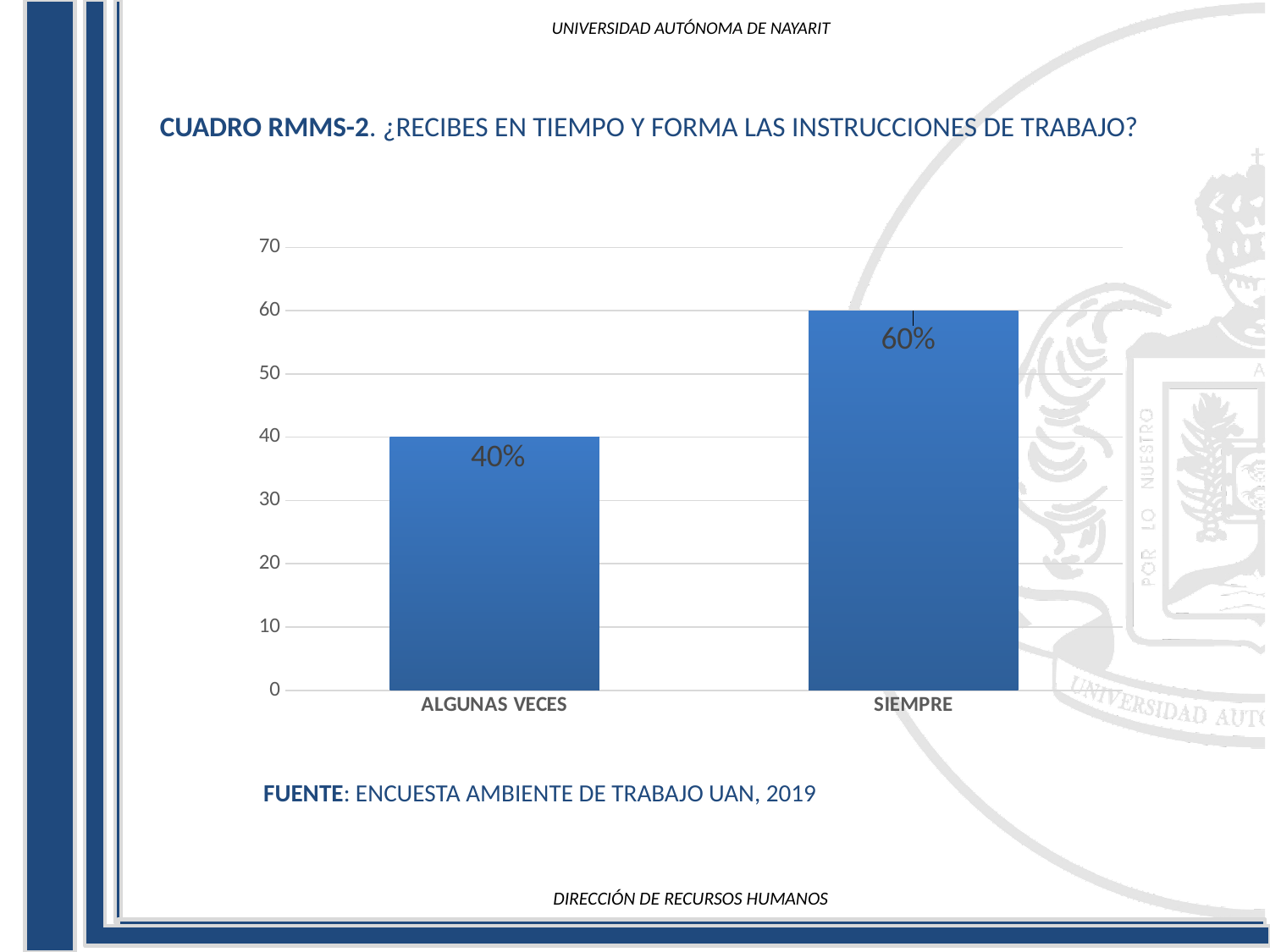
What kind of chart is shown on the slide? Bar chart Which is larger, the value for ALGUNAS VECES or the value for SIEMPRE? SIEMPRE How many categories are shown on the x axis? 2 What is the value for SIEMPRE? 60% Which category has the highest value? SIEMPRE Is the value for ALGUNAS VECES greater or less than 50? less What source is cited below the chart? ENCUESTA AMBIENTE DE TRABAJO UAN, 2019 What is the value for ALGUNAS VECES? 40% Which category has the lowest value? ALGUNAS VECES What is the difference between the values for SIEMPRE and ALGUNAS VECES? 20% Is the value for SIEMPRE greater or less than 50? greater What is the highest value shown on the vertical axis? 70